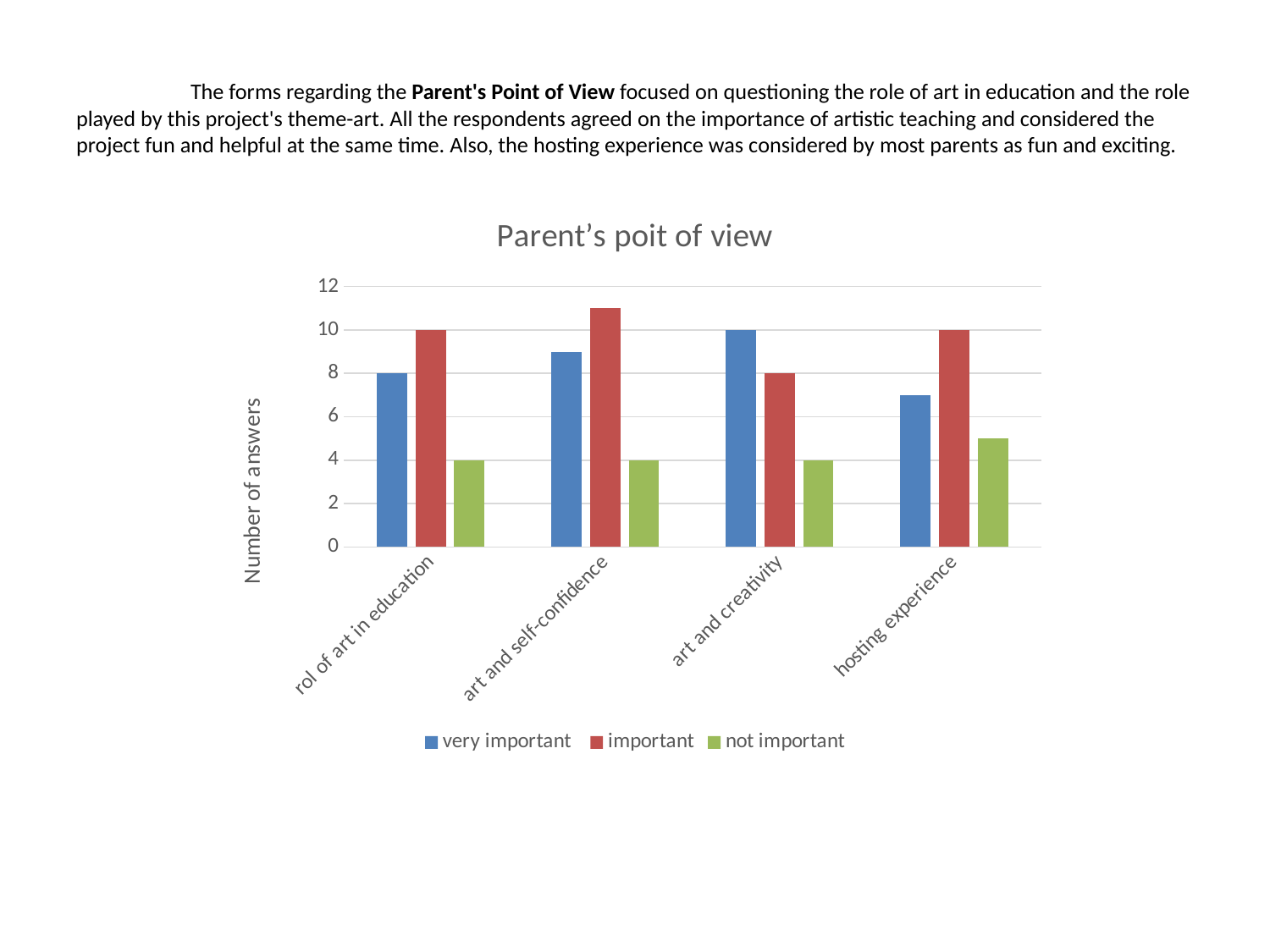
Which category has the highest 'important' value? art and self-confidence How many categories are shown on the x axis? 4 What type of chart is shown on the slide? bar chart What is the title of the chart? Parent’s poit of view What is the value for 'very important' in the 'rol of art in education' category? 8 Is the value for 'important' in the 'art and self-confidence' category greater or less than 10? greater What is the value for 'important' in the 'hosting experience' category? 10 What is the value for 'not important' in the 'art and self-confidence' category? 4 What is the value for 'important' in the 'art and creativity' category? 8 What is the difference between the 'important' and 'not important' values in the 'rol of art in education' category? 6 Is the value for 'very important' in the 'hosting experience' category greater or less than 8? less How many series does the legend list? 3